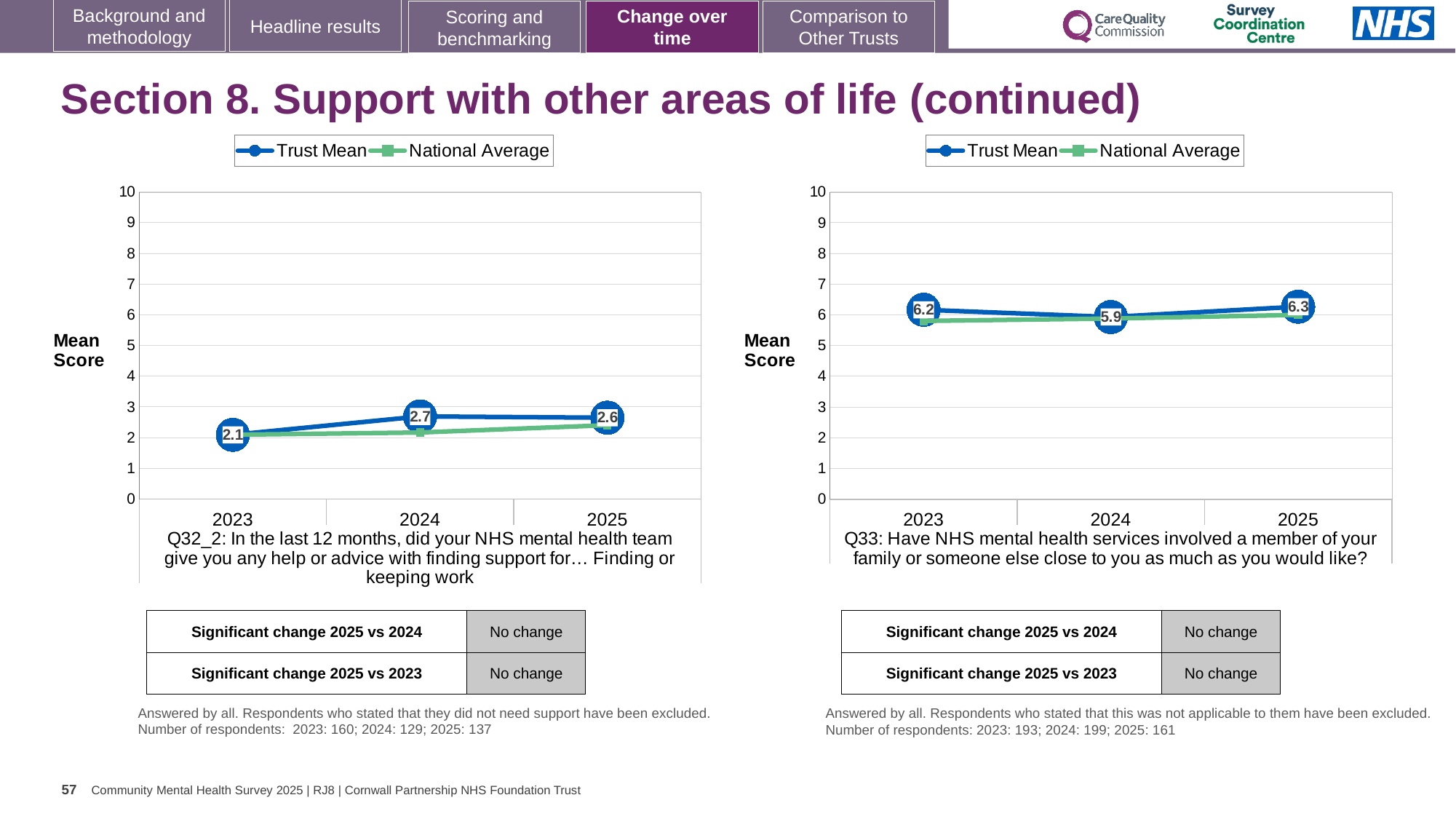
On the right chart (Q33), which year has the highest Trust Mean? 2025 On the left chart (Q32_2), what is the Trust Mean for 2023? 2.1 On the right chart (Q33), what is the Trust Mean for 2024? 5.9 How many series does the legend of the left chart list? 2 What kind of chart is the right chart (Q33)? Line chart On the left chart (Q32_2), what is the Trust Mean for 2024? 2.7 How many years are plotted on the left chart (Q32_2)? 3 On the right chart (Q33), what is the difference between the Trust Mean for 2025 and 2024? 0.4 On the right chart (Q33), is the Trust Mean for 2023 greater or less than 5? greater On the right chart (Q33), what is the Trust Mean for 2025? 6.3 On the left chart (Q32_2), what is the difference between the Trust Mean for 2024 and 2023? 0.6 On the left chart (Q32_2), which year has the lowest Trust Mean? 2023